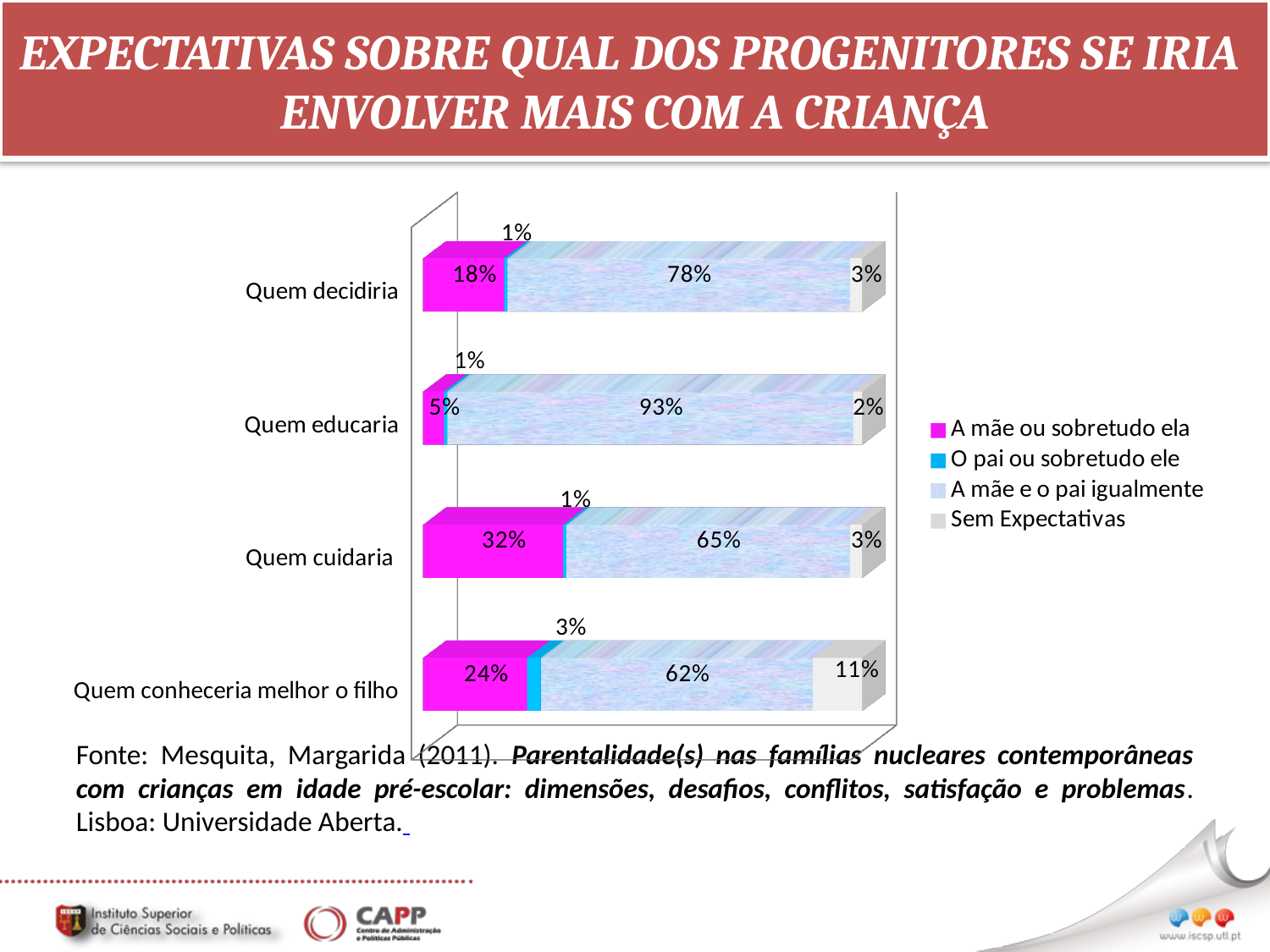
How many series does the legend list? 4 What is the difference between the 'A mãe e o pai igualmente' values for 'Quem educaria' and 'Quem decidiria'? 15% Which is larger: the 'A mãe ou sobretudo ela' value for 'Quem decidiria' or for 'Quem conheceria melhor o filho'? Quem conheceria melhor o filho What kind of chart is shown on the slide? Stacked bar chart What is the value for 'A mãe ou sobretudo ela' in the 'Quem cuidaria' bar? 32% How many categories are plotted on the chart? 4 What is the value for 'A mãe e o pai igualmente' in the 'Quem educaria' bar? 93% What is the value for 'O pai ou sobretudo ele' in the 'Quem decidiria' bar? 1% Which category has the lowest value for 'A mãe e o pai igualmente'? Quem conheceria melhor o filho Which legend entry is shown in magenta? A mãe ou sobretudo ela Which category has the highest value for 'A mãe ou sobretudo ela'? Quem cuidaria What is the value for 'Sem Expectativas' in the 'Quem conheceria melhor o filho' bar? 11%